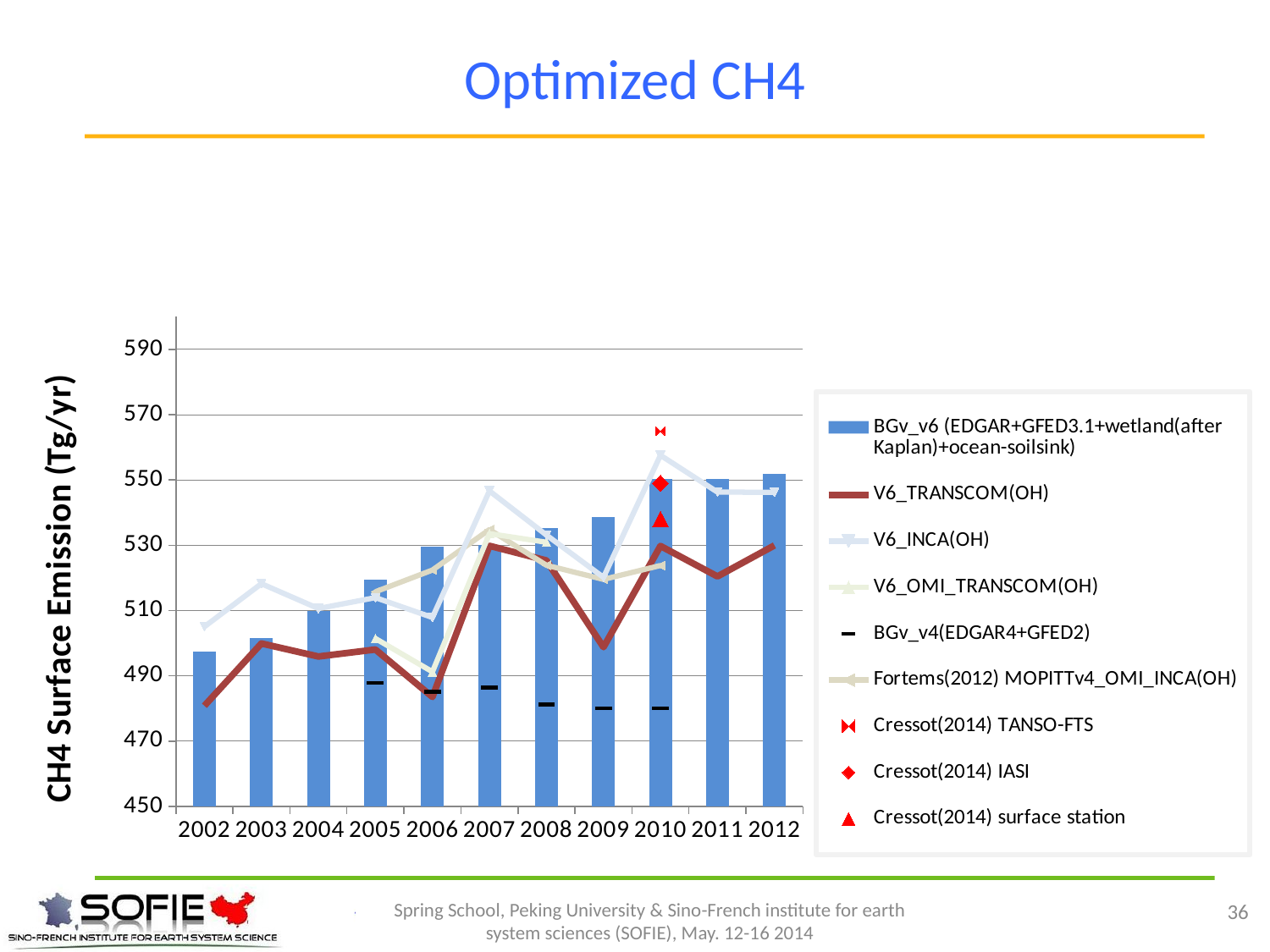
Is the BGv_v6 bar for 2005 greater or less than 510? greater What is the label on the y axis? CH4 Surface Emission (Tg/yr) Is the Cressot(2014) TANSO-FTS value for 2010 greater or less than 550? greater What kind of chart is shown on the slide? combination bar and line chart Is the BGv_v6 bar for 2009 greater or less than 530? greater Do the BGv_v6 bars generally rise or fall from 2002 to 2012? rise How many series does the legend list? 9 Which year has the lowest BGv_v6 bar? 2002 How many years are shown along the x axis? 11 Which BGv_v6 bar is taller, 2005 or 2009? 2009 What is the title of the slide? Optimized CH4